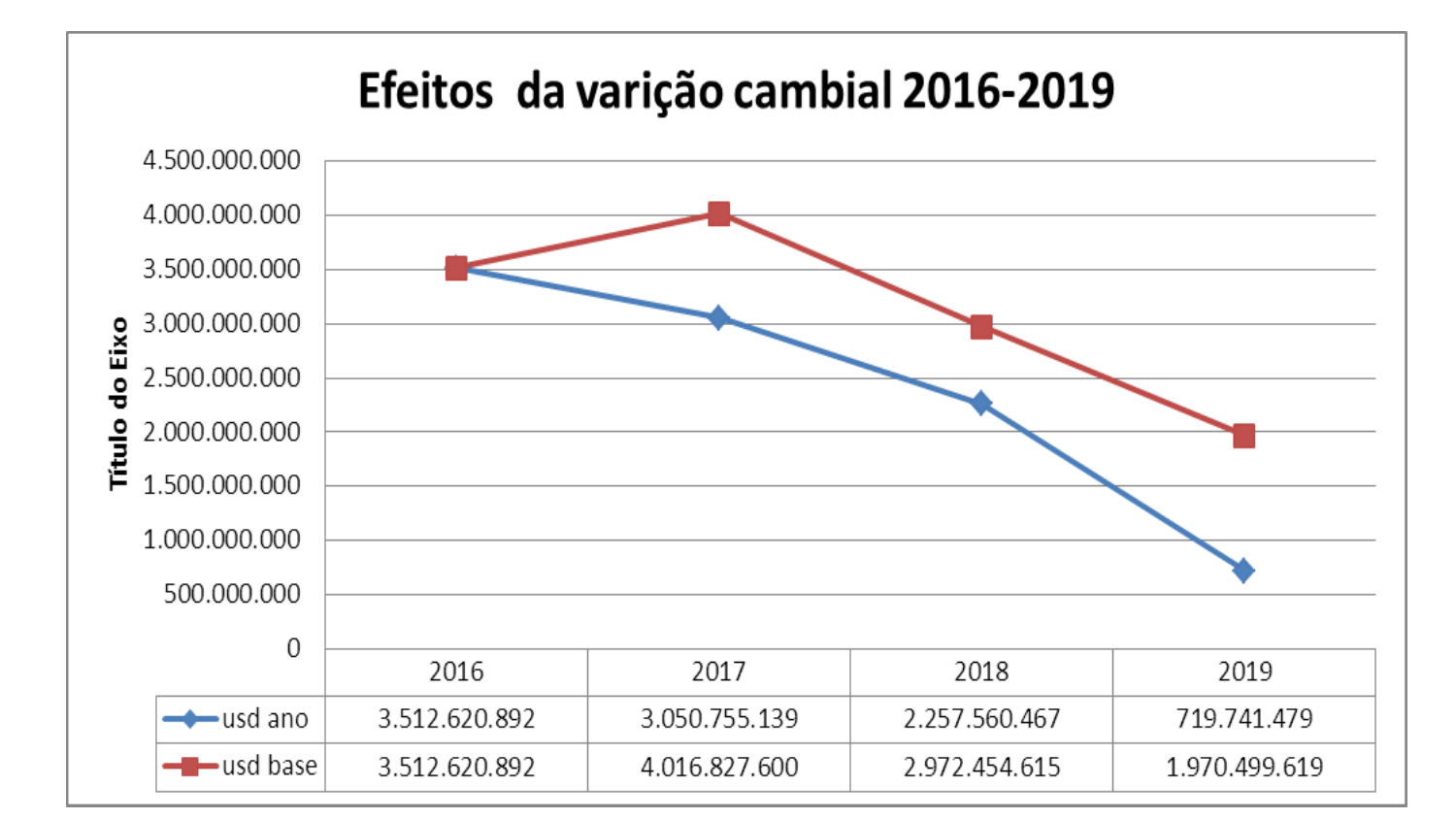
What is the difference between usd base and usd ano in 2017? 966.072.461 What is the value of usd ano in 2018? 2.257.560.467 What is the value of usd base in 2017? 4.016.827.600 What is the value of usd ano in 2019? 719.741.479 What kind of chart is shown? line chart Is the value of usd base in 2019 greater or less than 1.500.000.000? greater In which year is usd base highest? 2017 How many series does the legend list? 2 How many years are plotted on the x axis? 4 Which is larger in 2018, usd ano or usd base? usd base What is the difference between usd base and usd ano in 2019? 1.250.758.140 In which year is usd ano lowest? 2019